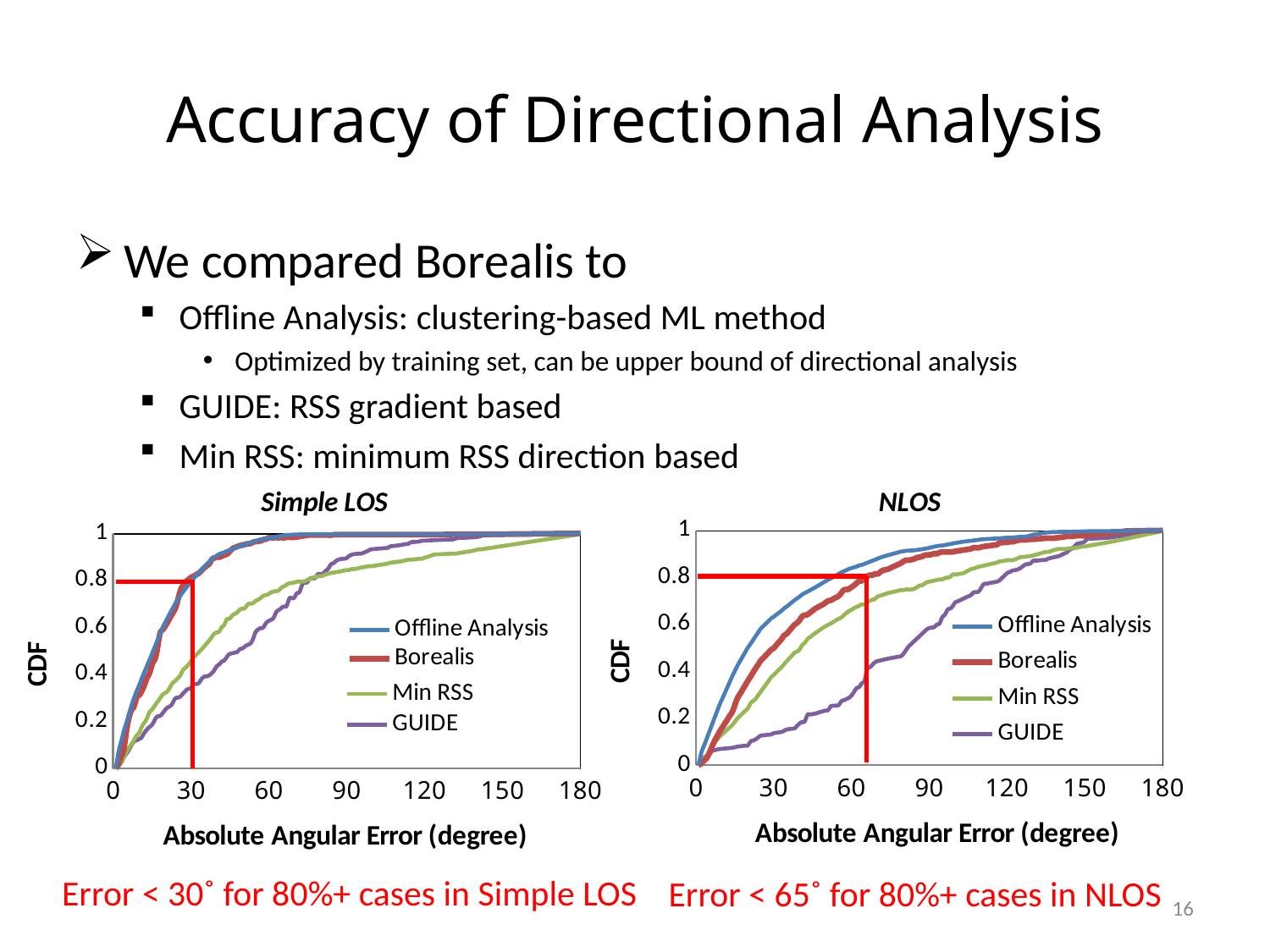
In the NLOS chart, is the CDF value for GUIDE at 60 degrees greater or less than 0.6? less In the Simple LOS chart, do the CDF curves rise or fall as the absolute angular error increases? rise In the Simple LOS chart, at 60 degrees, which series has the higher CDF value: Borealis or Min RSS? Borealis In the NLOS chart, is the CDF value for Offline Analysis at 30 degrees greater or less than 0.4? greater In the Simple LOS chart, is the CDF value for GUIDE at 60 degrees greater or less than 0.8? less What is the x-axis label of the NLOS chart? Absolute Angular Error (degree) What are the four series listed in the legend of the Simple LOS chart? Offline Analysis, Borealis, Min RSS, GUIDE How many series does the legend of the NLOS chart list? 4 In the NLOS chart, at 60 degrees, which series has the higher CDF value: Offline Analysis or GUIDE? Offline Analysis What kind of chart is the Simple LOS chart? line chart